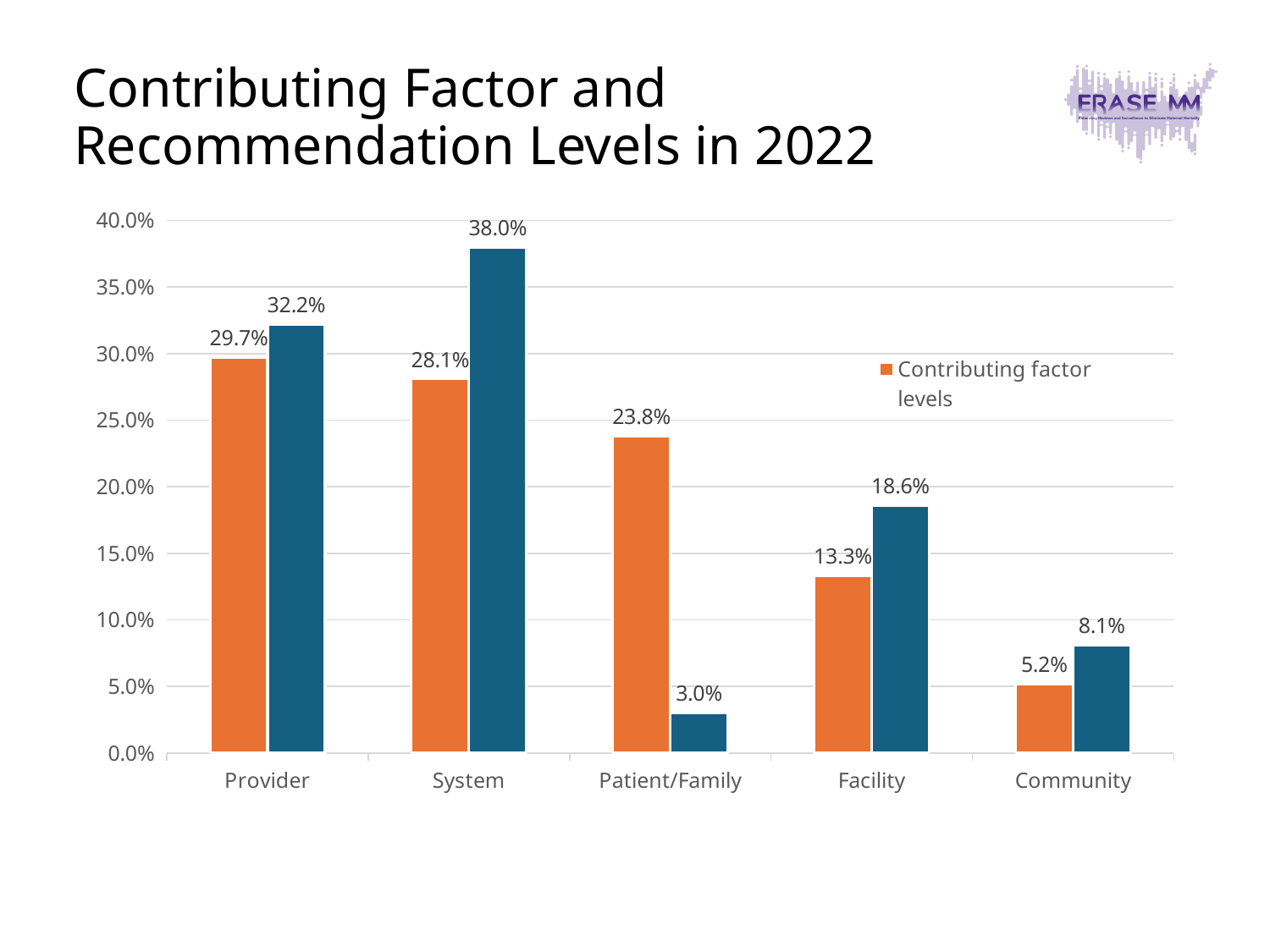
What is the difference between the blue bar and the orange bar for Facility? 5.3% What is the value of the blue bar for Community? 8.1% What is the Contributing factor levels value for Provider? 29.7% How many categories are shown on the x axis? 5 What is the Contributing factor levels value for Patient/Family? 23.8% For Patient/Family, which is larger: the Contributing factor levels bar or the blue bar? Contributing factor levels Which category has the highest Contributing factor levels value? Provider What is the title of the chart on the slide? Contributing Factor and Recommendation Levels in 2022 How many series does the legend list? 1 What kind of chart is shown on the slide? Bar chart Which category has the lowest value for the blue bars? Patient/Family What is the value of the blue bar for System? 38.0%